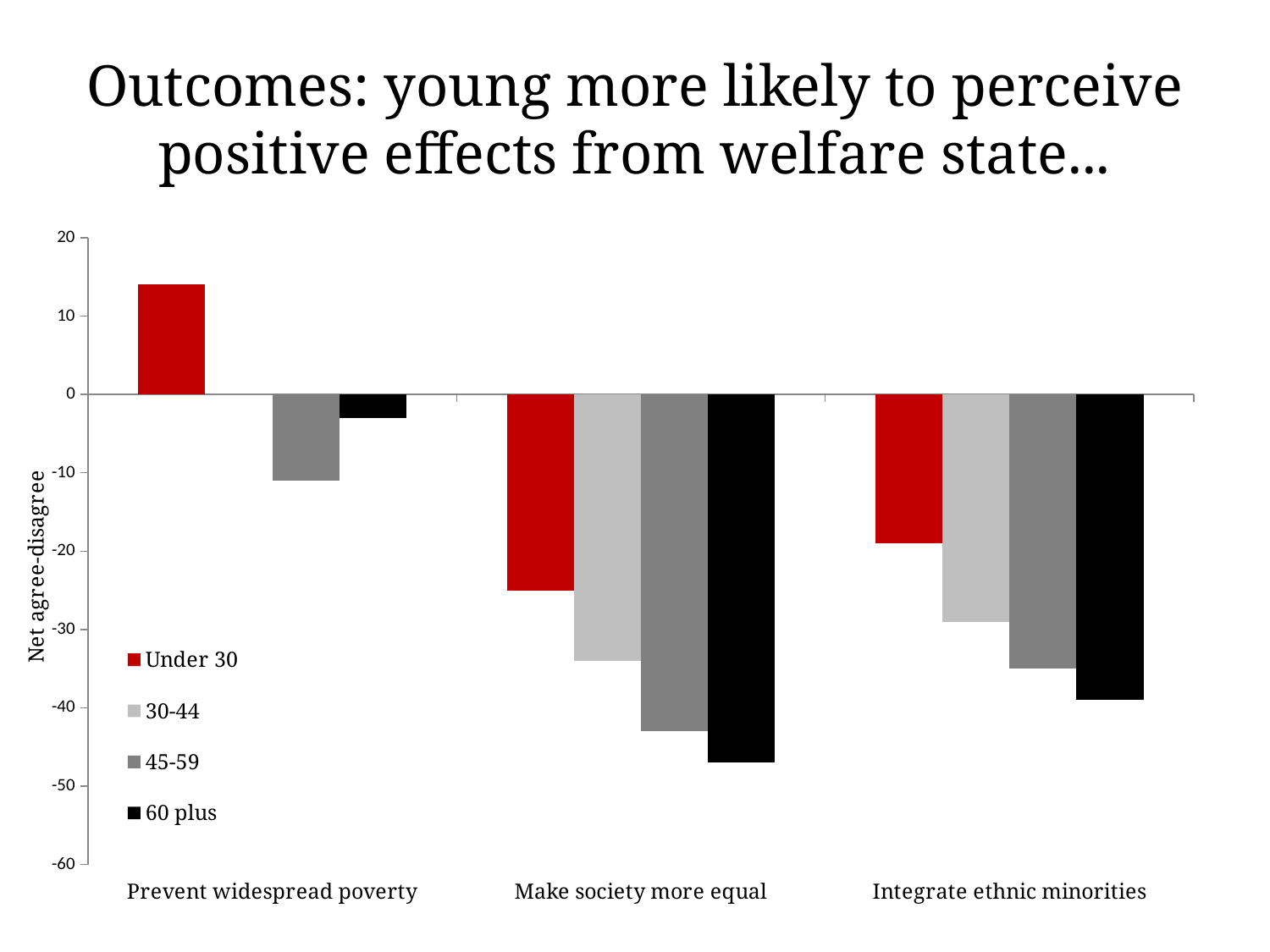
Does the Under 30 value rise or fall from Prevent widespread poverty to Make society more equal? fall Which age group has the lowest value for Integrate ethnic minorities? 60 plus What kind of chart is shown on the slide? bar chart Which age group has the lowest value for Make society more equal? 60 plus How many age groups does the legend list? 4 Is the value for Under 30 on Prevent widespread poverty greater or less than 10? greater Is the value for Under 30 on Make society more equal greater or less than -20? less How many outcome categories are shown on the x axis? 3 For Integrate ethnic minorities, which is larger: the value for Under 30 or the value for 60 plus? Under 30 What is the label on the vertical axis? Net agree-disagree Which age group has the highest value for Prevent widespread poverty? Under 30 Is the value for 60 plus on Make society more equal greater or less than -40? less